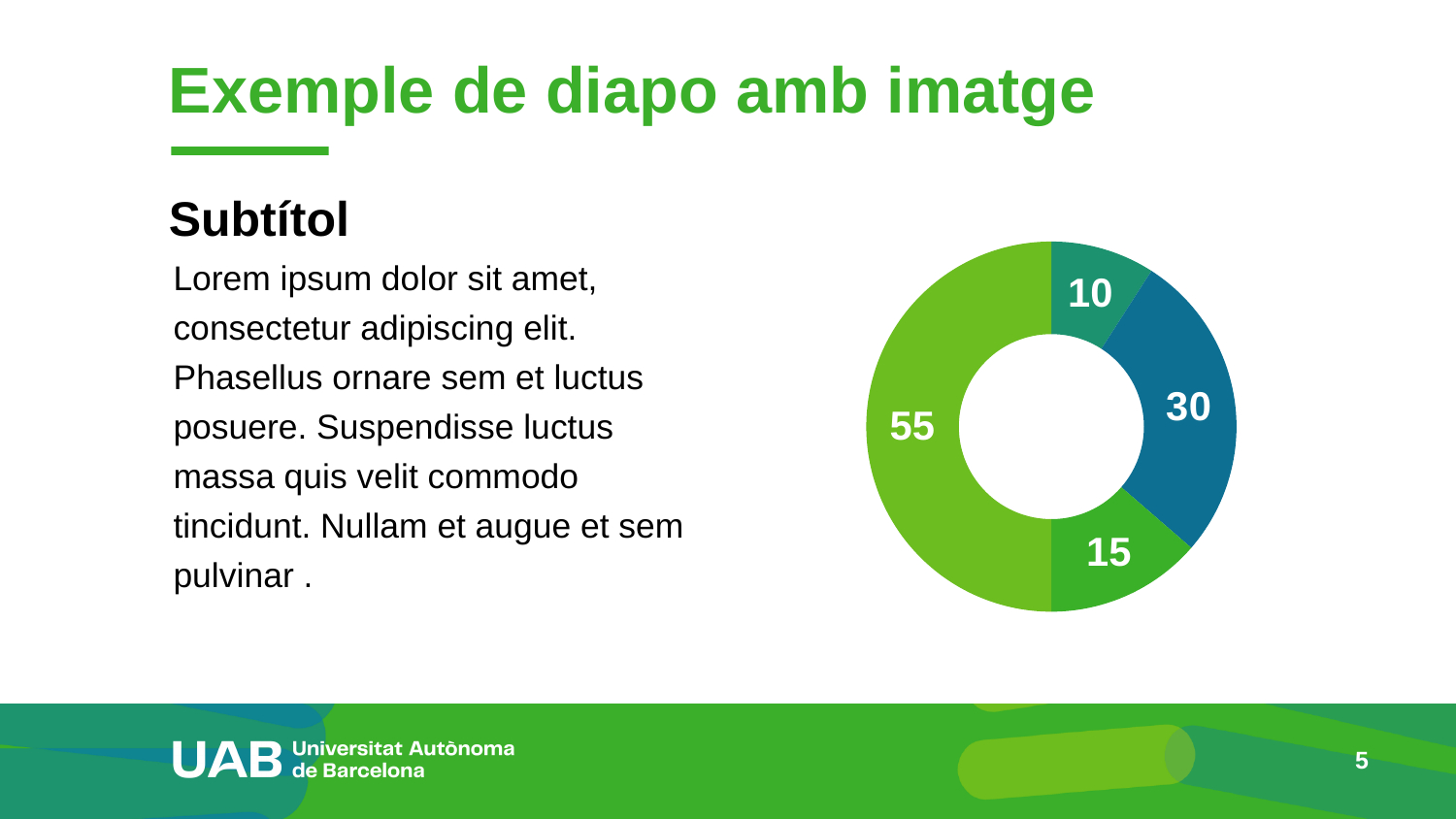
What value is shown on the dark blue slice of the doughnut chart? 30 What is the largest value shown on the doughnut chart? 55 What is the difference between the largest slice (55) and the slice labelled 30? 25 What value is shown on the largest, light green slice of the doughnut chart? 55 What share of the whole doughnut does the slice labelled 55 represent? 50% What is the difference between the slices labelled 15 and 10? 5 How many slices does the doughnut chart have? 4 What is the smallest value shown on the doughnut chart? 10 Does the doughnut chart have a legend? No What is the total of all the values shown on the doughnut chart? 110 Which is larger, the slice labelled 30 or the slice labelled 15? 30 What kind of chart is shown on the slide? Doughnut chart